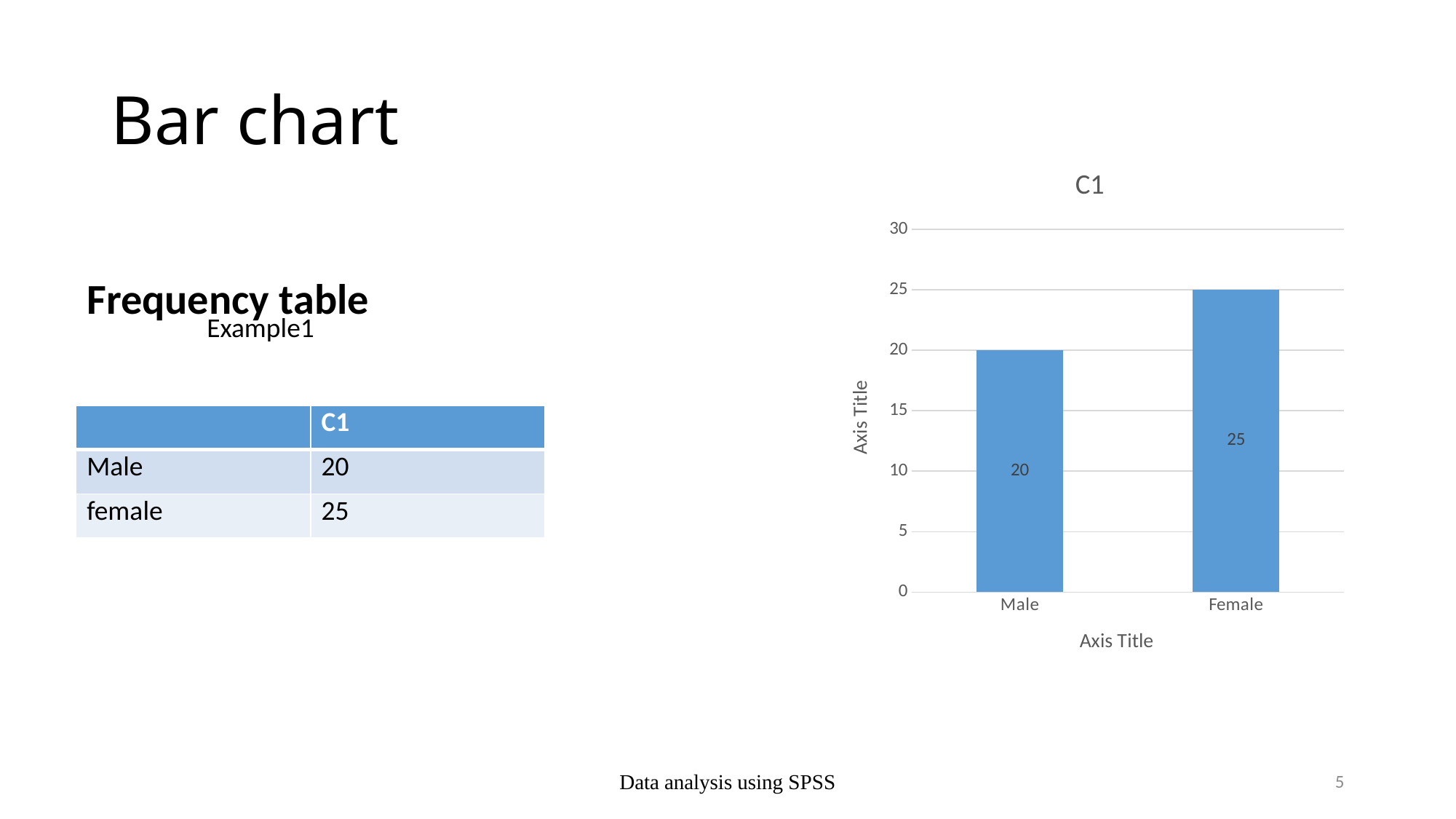
What is the value for Male in the chart? 20 Which is larger, the value for Male or the value for Female? Female Which category has the highest value in the chart? Female Is the value for Male greater or less than 25? less Is the value for Female greater or less than 20? greater What is the highest value shown on the chart's vertical axis? 30 Which category has the lowest value in the chart? Male What is the value for Female in the chart? 25 What kind of chart is shown on the slide? bar chart How many categories are shown on the x axis of the chart? 2 What is the difference between the values for Female and Male? 5 What is the title of the chart? C1